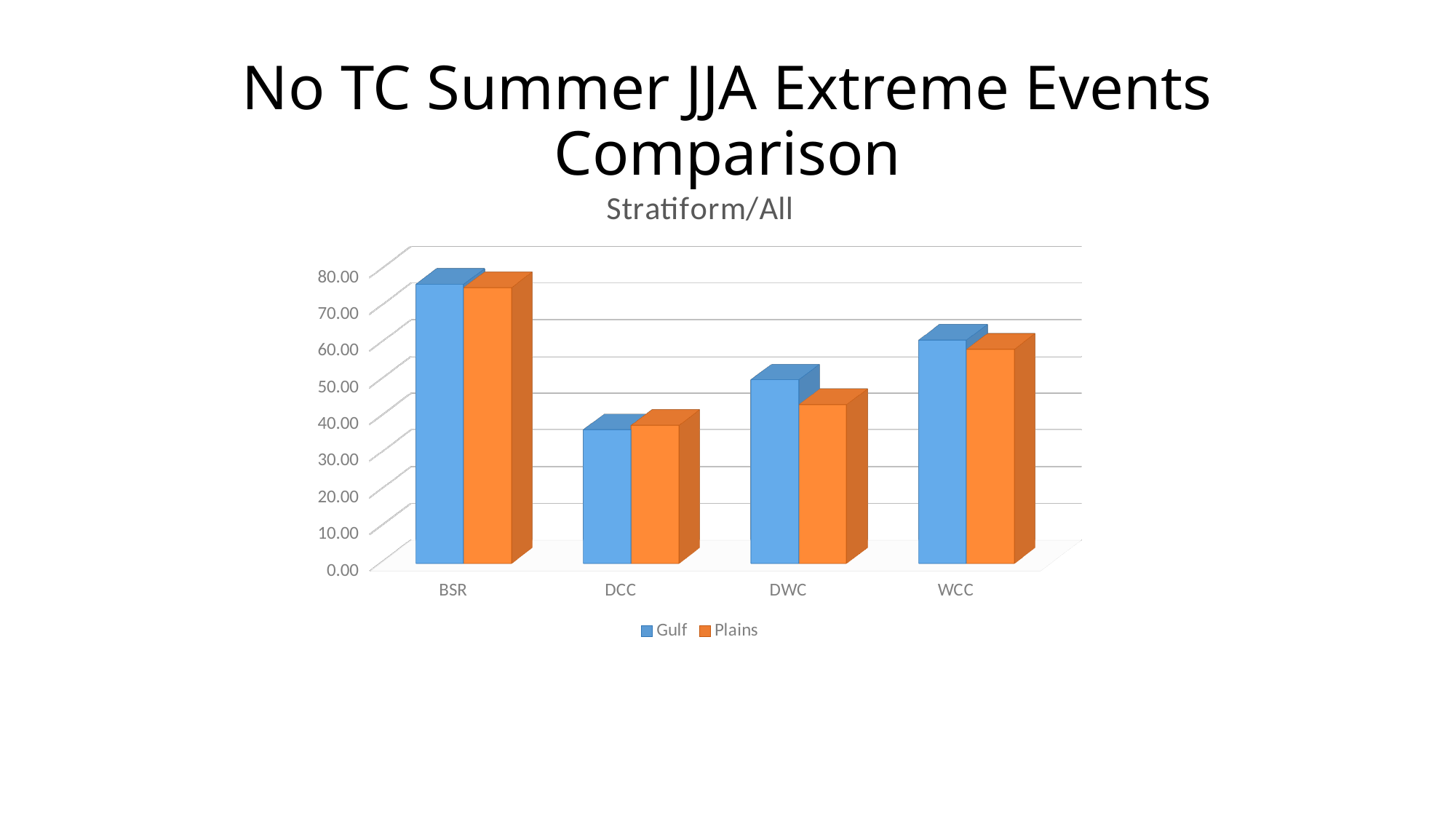
Which category has the highest Plains value? BSR How many categories are shown on the x axis? 4 Which category has the highest Gulf value? BSR Which category has the lowest Gulf value? DCC What kind of chart is shown on the slide? Bar chart Which colour represents the Plains series in the legend? Orange Is the Gulf value for BSR greater or less than 70.00? greater How many series does the legend list? 2 Is the Gulf value for DCC greater or less than 40.00? less For DWC, which series has the larger value, Gulf or Plains? Gulf Is the Plains value for DWC greater or less than 50.00? less What is the title of the chart? Stratiform/All